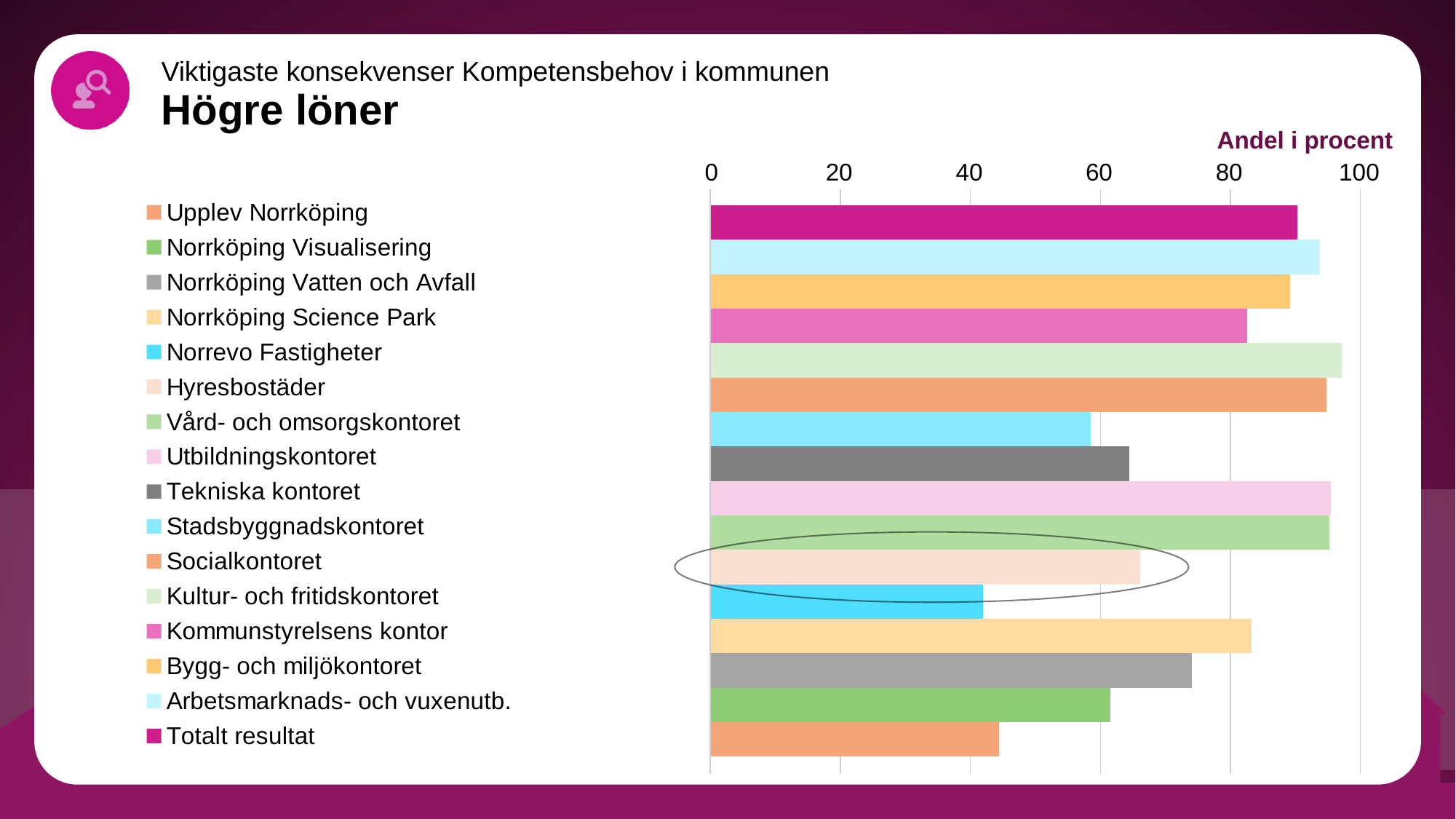
Is the value for Totalt resultat greater or less than 80? greater Is the value for Hyresbostäder greater or less than 80? less Which is larger, the value for Socialkontoret or the value for Stadsbyggnadskontoret? Socialkontoret How many bars are plotted in the chart? 16 Which is larger, the value for Tekniska kontoret or the value for Norrevo Fastigheter? Tekniska kontoret Is the value for Tekniska kontoret greater or less than 80? less What is the label shown above the horizontal axis of the chart? Andel i procent What kind of chart is shown on the slide? bar chart How many series does the legend list? 16 What is the bold title of the slide above the chart? Högre löner